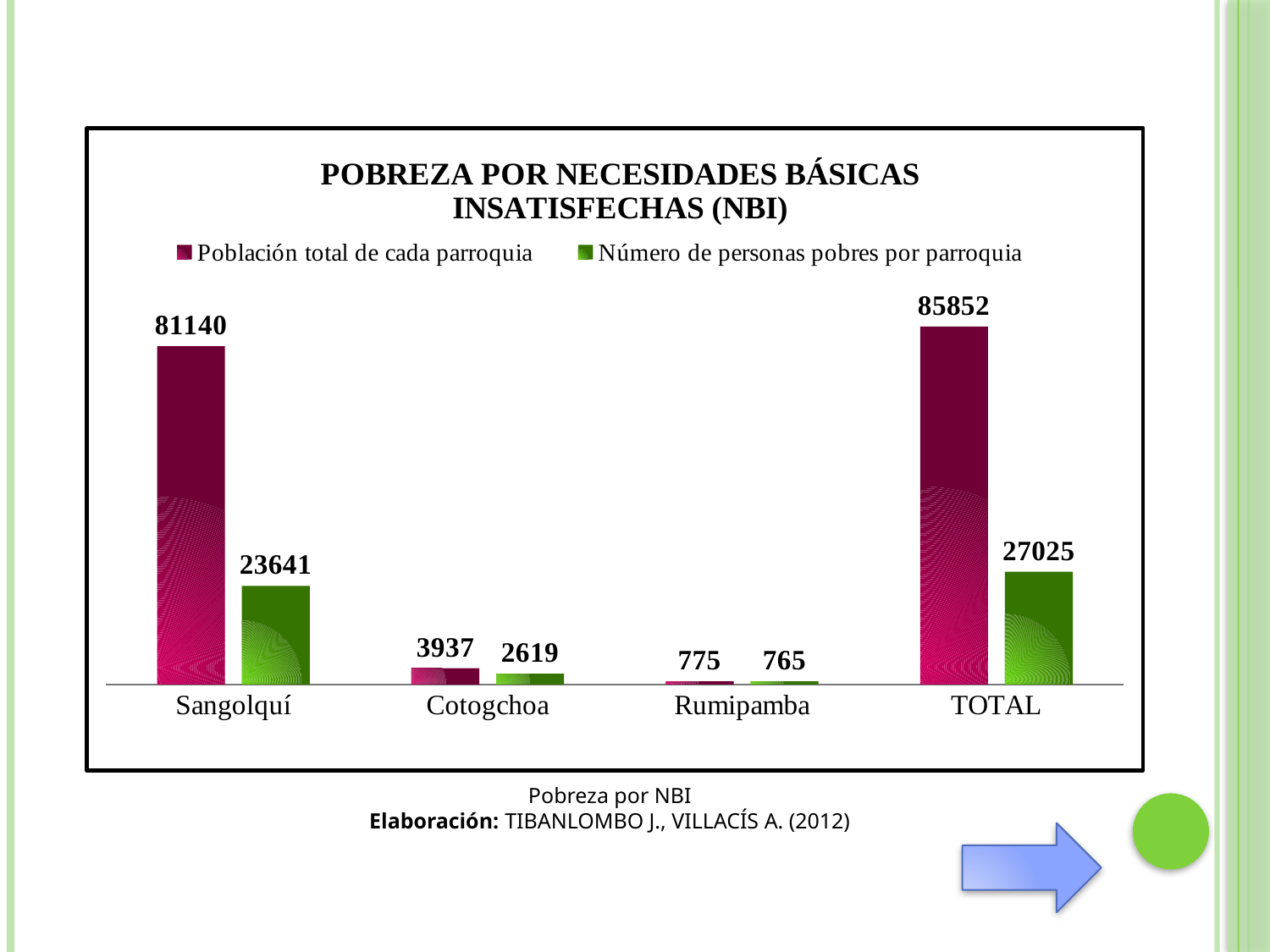
Which is larger: 'Población total de cada parroquia' for Cotogchoa or 'Número de personas pobres por parroquia' for Sangolquí? Número de personas pobres por parroquia for Sangolquí What is the value of 'Número de personas pobres por parroquia' for Cotogchoa? 2619 How many categories are shown on the x axis? 4 What kind of chart is shown on the slide? Bar chart What is the difference between 'Población total de cada parroquia' and 'Número de personas pobres por parroquia' for Sangolquí? 57499 How many series does the legend list? 2 What is the value of 'Número de personas pobres por parroquia' for TOTAL? 27025 Which category has the lowest value for 'Número de personas pobres por parroquia'? Rumipamba What is the title of the chart? POBREZA POR NECESIDADES BÁSICAS INSATISFECHAS (NBI) What is the value of 'Población total de cada parroquia' for Sangolquí? 81140 Excluding TOTAL, which parroquia has the highest 'Población total de cada parroquia'? Sangolquí What is the value of 'Población total de cada parroquia' for Rumipamba? 775